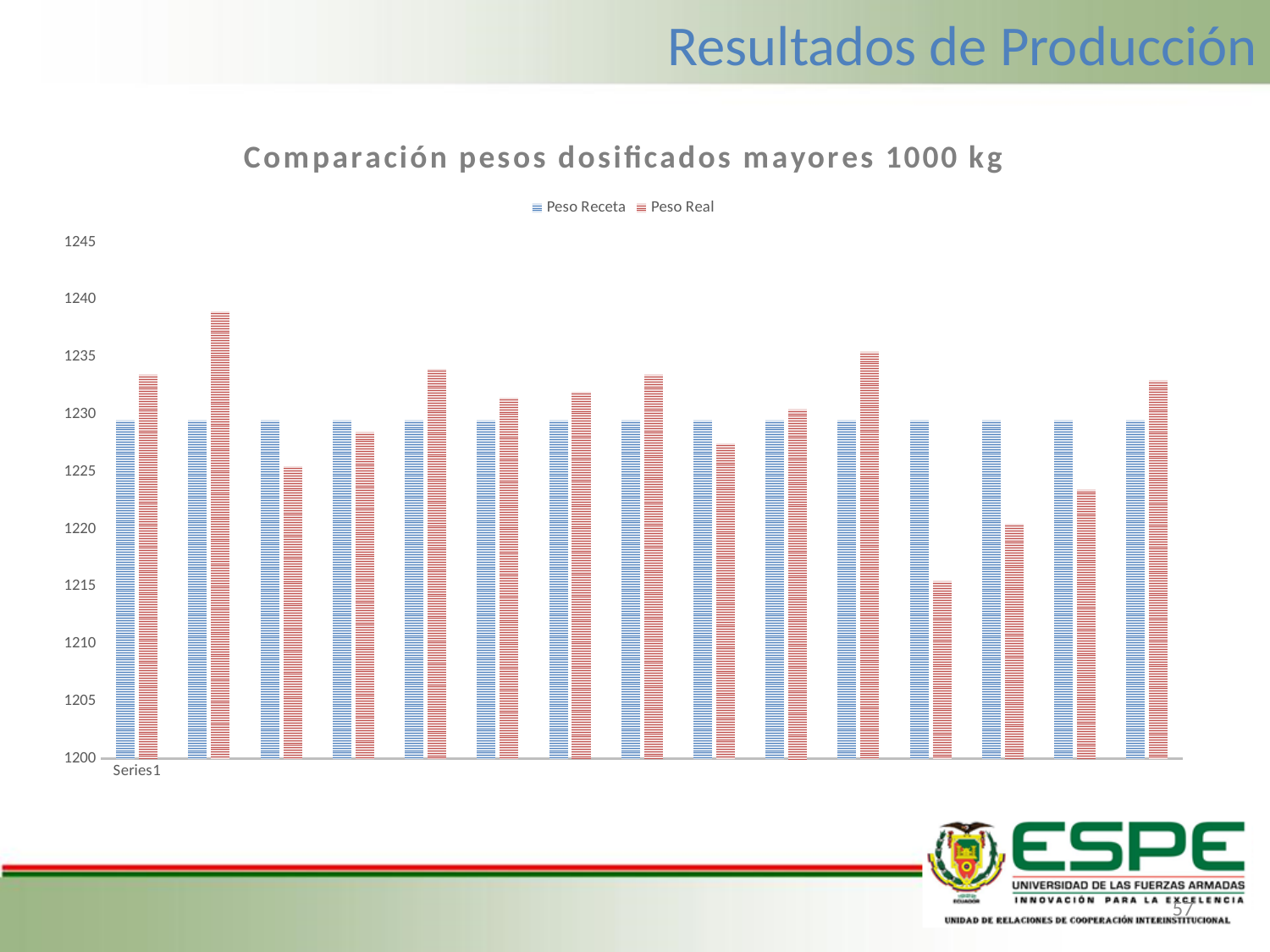
Is the highest Peso Real bar greater or less than 1235? greater Is the second Peso Real bar from the left greater or less than 1235? greater Is the lowest Peso Real bar greater or less than 1220? less How many series does the legend list? 2 What is the lowest value shown on the vertical axis? 1200 What kind of chart is shown on the slide? bar chart Do the Peso Receta values rise, fall, or stay constant across the bars? stay constant What is the title of the chart? Comparación pesos dosificados mayores 1000 kg Which series is drawn in red? Peso Real How many pairs of bars (Peso Receta and Peso Real) are plotted? 15